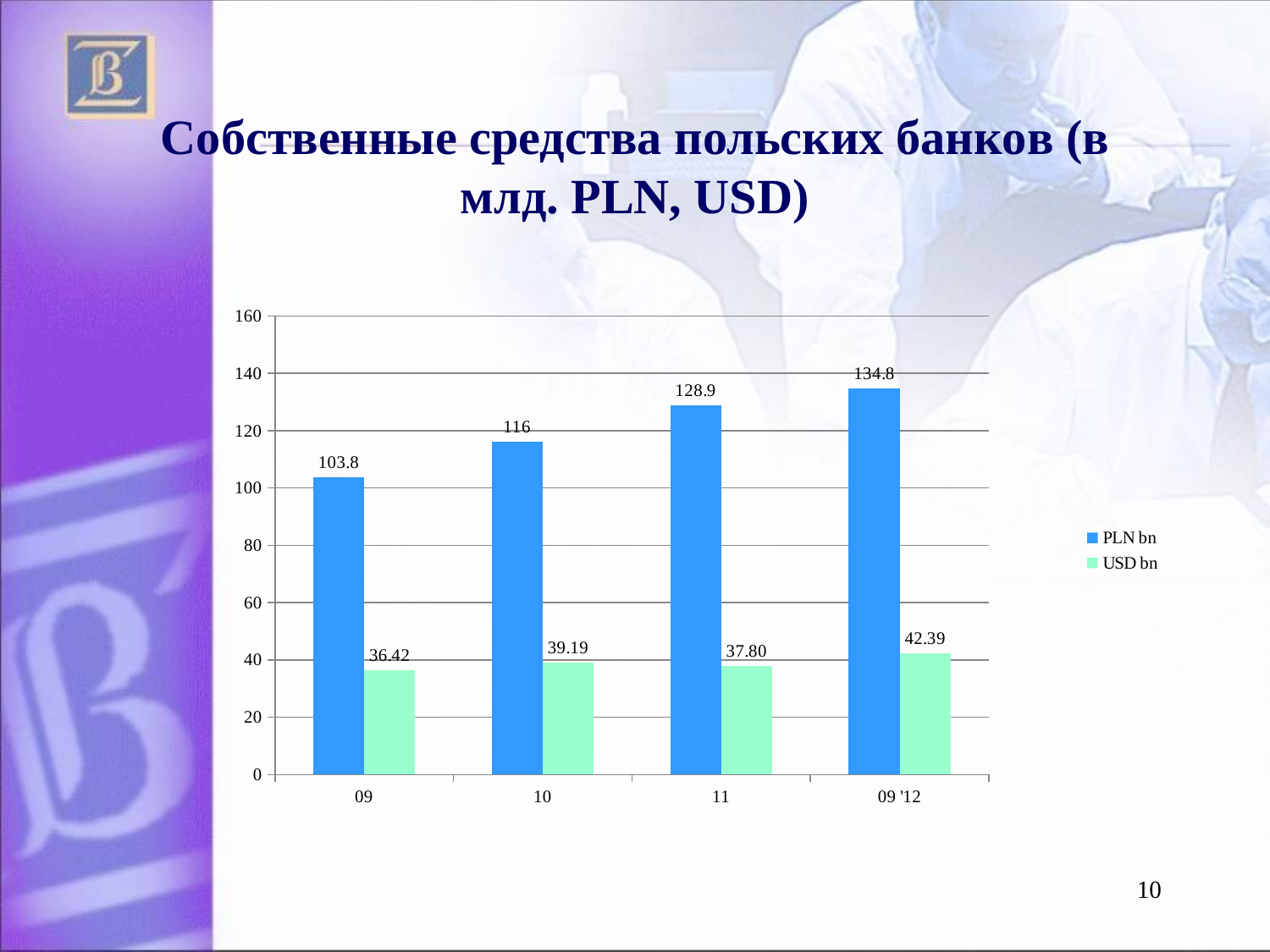
How many series does the legend list? 2 What is the PLN bn value for 09? 103.8 Which category has the lowest USD bn value? 09 What is the PLN bn value for 09 '12? 134.8 Do the PLN bn values rise or fall from 09 to 09 '12? rise What is the USD bn value for 10? 39.19 What is the difference between the PLN bn values for 11 and 10? 12.9 Which is larger, the USD bn value for 10 or for 11? 10 What is the USD bn value for 11? 37.80 What kind of chart is shown on the slide? bar chart How many categories are shown on the x axis? 4 Which category has the highest PLN bn value? 09 '12